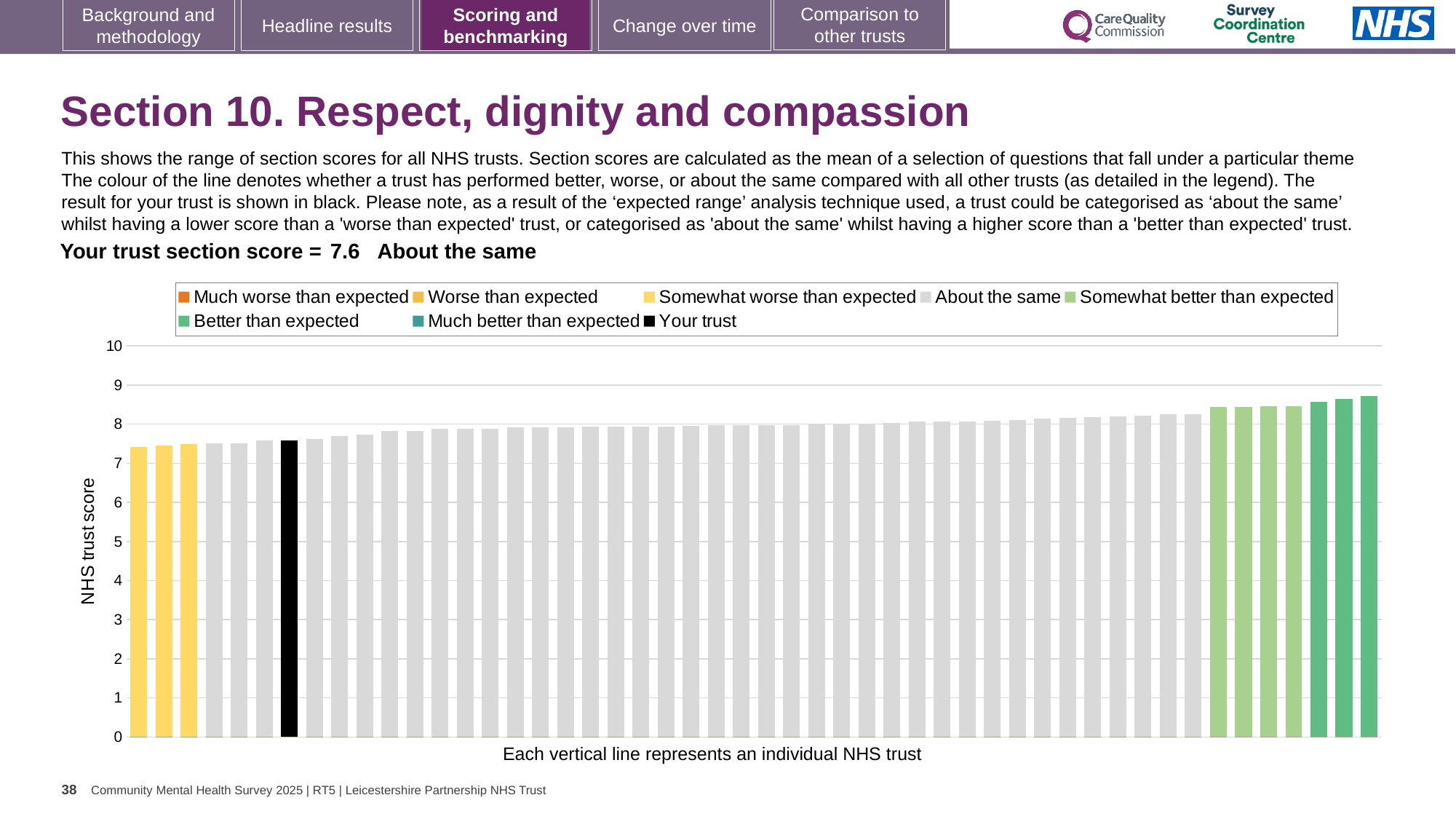
Is the value of the tallest bar in the chart greater or less than 8? greater Do the bar values rise or fall from left to right across the chart? Rise Is the value for your trust (the black bar) greater or less than 7? greater Is the value of the shortest bar in the chart greater or less than 7? greater What is the section score for your trust shown on the slide? 7.6 According to the caption below the chart, what does each vertical line represent? An individual NHS trust What kind of chart is shown on the slide? Bar chart How many yellow bars are shown at the left of the chart? 3 How many entries does the chart legend list? 8 What is the label on the vertical axis of the chart? NHS trust score How is your trust's section score categorised compared with other trusts? About the same